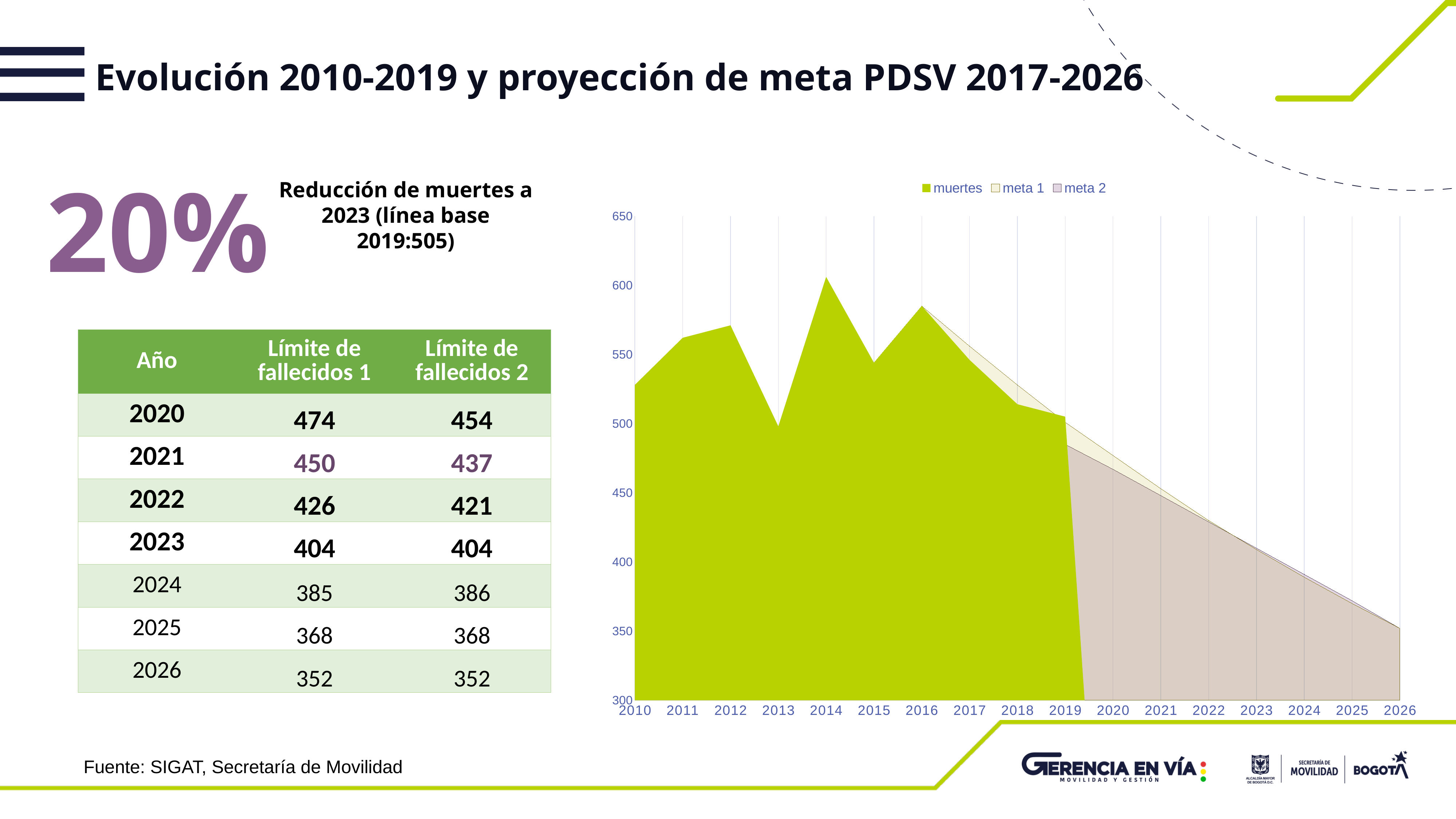
Is the muertes value for 2016 greater or less than 550? greater What kind of chart is shown on the slide? area chart Is the meta value for 2026 greater or less than 400? less How many years are shown on the x axis of the chart? 17 Which year has the higher muertes value, 2011 or 2013? 2011 Is the muertes value for 2013 greater or less than 550? less What are the three series named in the chart legend? muertes, meta 1, meta 2 Which year has the higher muertes value, 2015 or 2018? 2015 Do the meta series rise or fall from 2020 to 2026? fall How many series does the chart legend list? 3 In which year does the muertes series reach its highest value? 2014